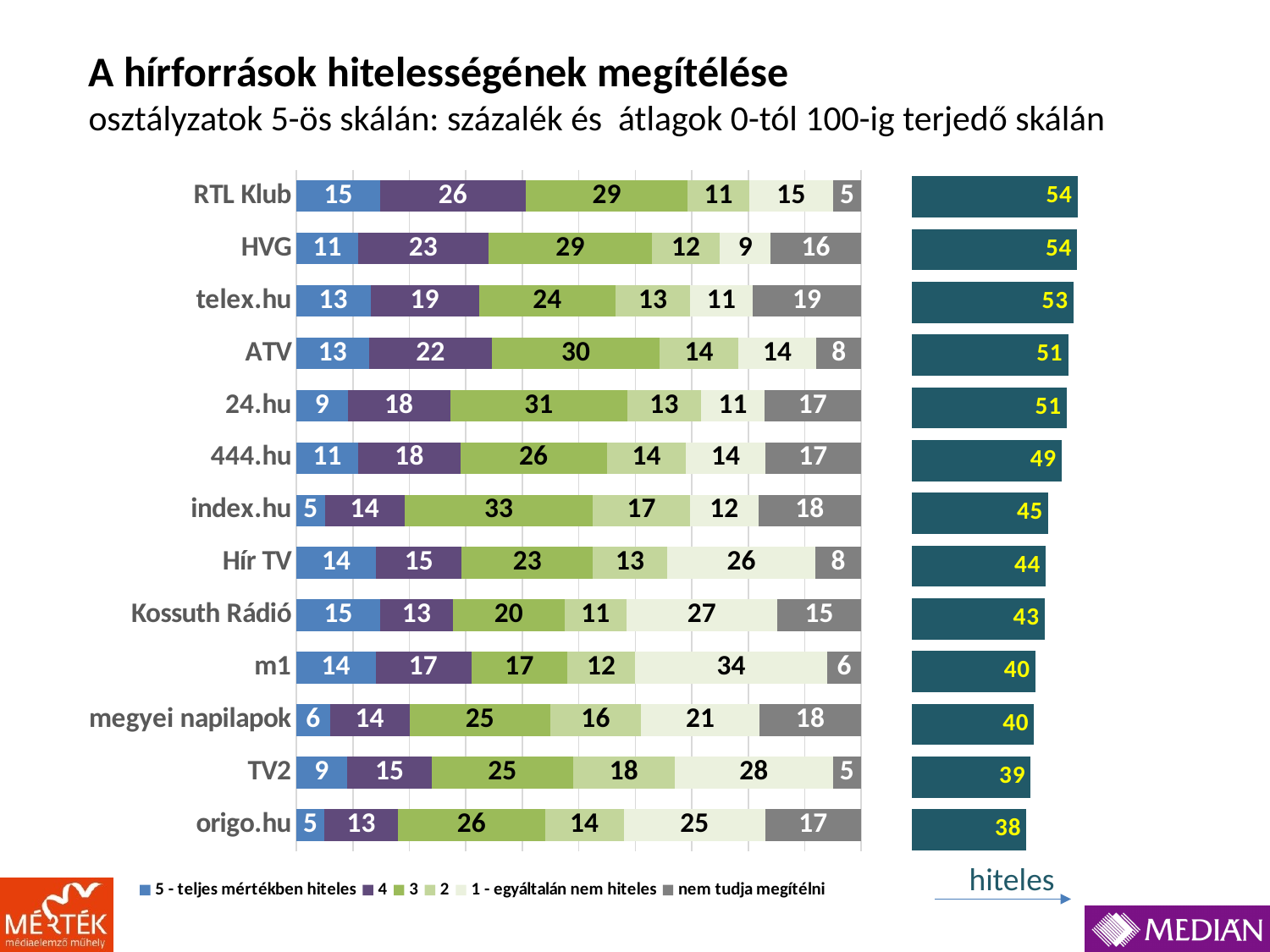
How many series does the legend of the stacked bar chart on the left list? 6 In the stacked bar chart on the left, what is the value of "nem tudja megítélni" for telex.hu? 19 In the stacked bar chart on the left, what is the total of the HVG bar? 100 In the stacked bar chart on the left, which news source has the highest value for the "3" series? index.hu In the bar chart on the right, which news source has the lowest value? origo.hu In the stacked bar chart on the left, what is the value of "5 - teljes mértékben hiteles" for RTL Klub? 15 In the bar chart on the right, what is the value for telex.hu? 53 In the bar chart on the right, what is the difference between the values for RTL Klub and origo.hu? 16 In the bar chart on the right, do the values increase or decrease going down from RTL Klub to origo.hu? Decrease How many news sources are listed in the stacked bar chart on the left? 13 What kind of chart is the chart on the left? Stacked bar chart In the stacked bar chart on the left, which has the larger "1 - egyáltalán nem hiteles" value, m1 or TV2? m1